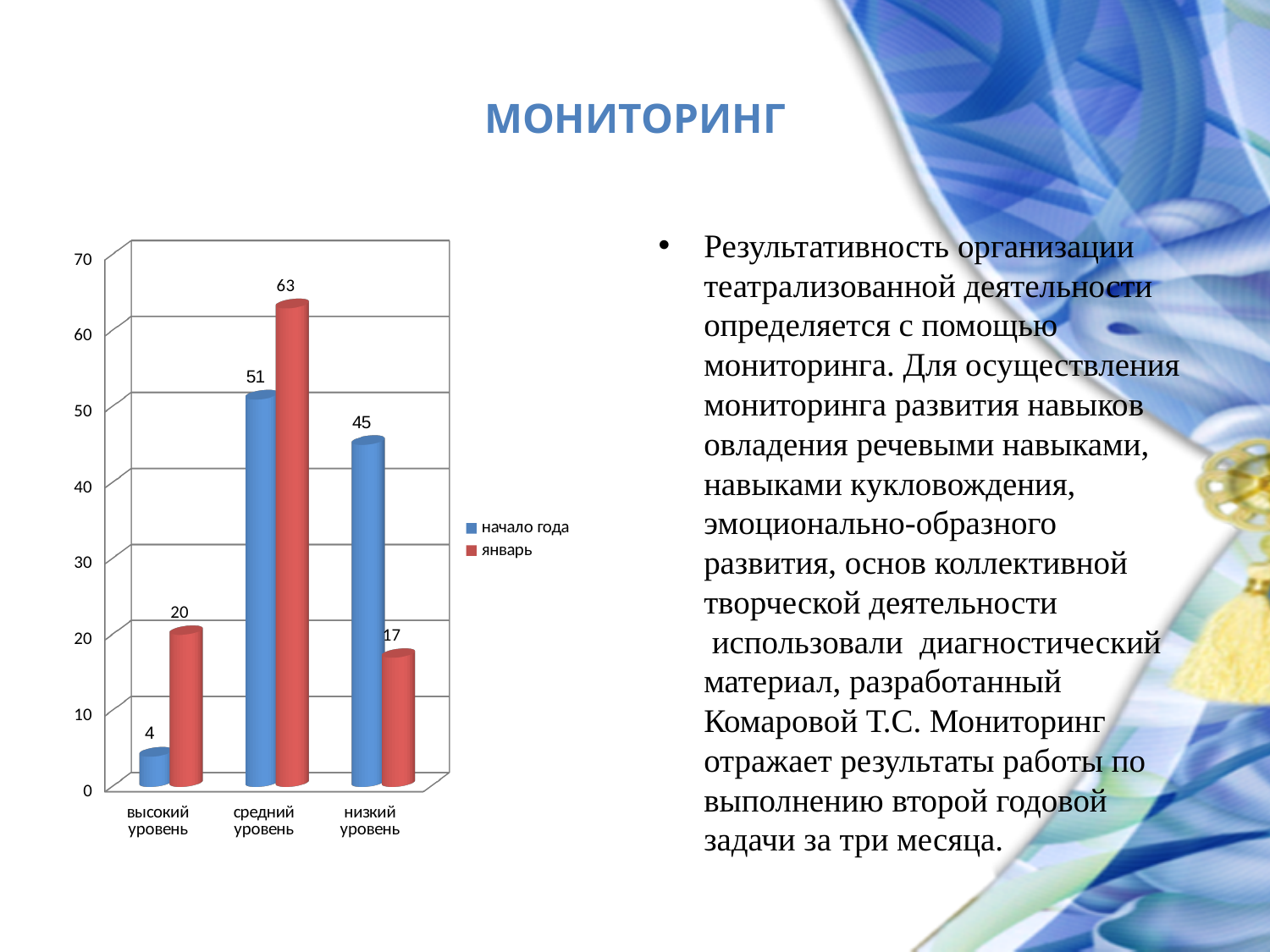
How many categories are shown on the x axis? 3 What is the difference between the "январь" and "начало года" values at "средний уровень"? 12 What is the value for "январь" at "средний уровень"? 63 Which is larger at "низкий уровень": "начало года" or "январь"? начало года Is the value for "январь" at "высокий уровень" greater or less than 10? greater What is the value for "январь" at "низкий уровень"? 17 How many series does the legend list? 2 What kind of chart is shown on the slide? bar chart Which category has the highest value for the "январь" series? средний уровень What is the value for "начало года" at "низкий уровень"? 45 Which category has the lowest value for the "начало года" series? высокий уровень What is the value for "начало года" at "высокий уровень"? 4